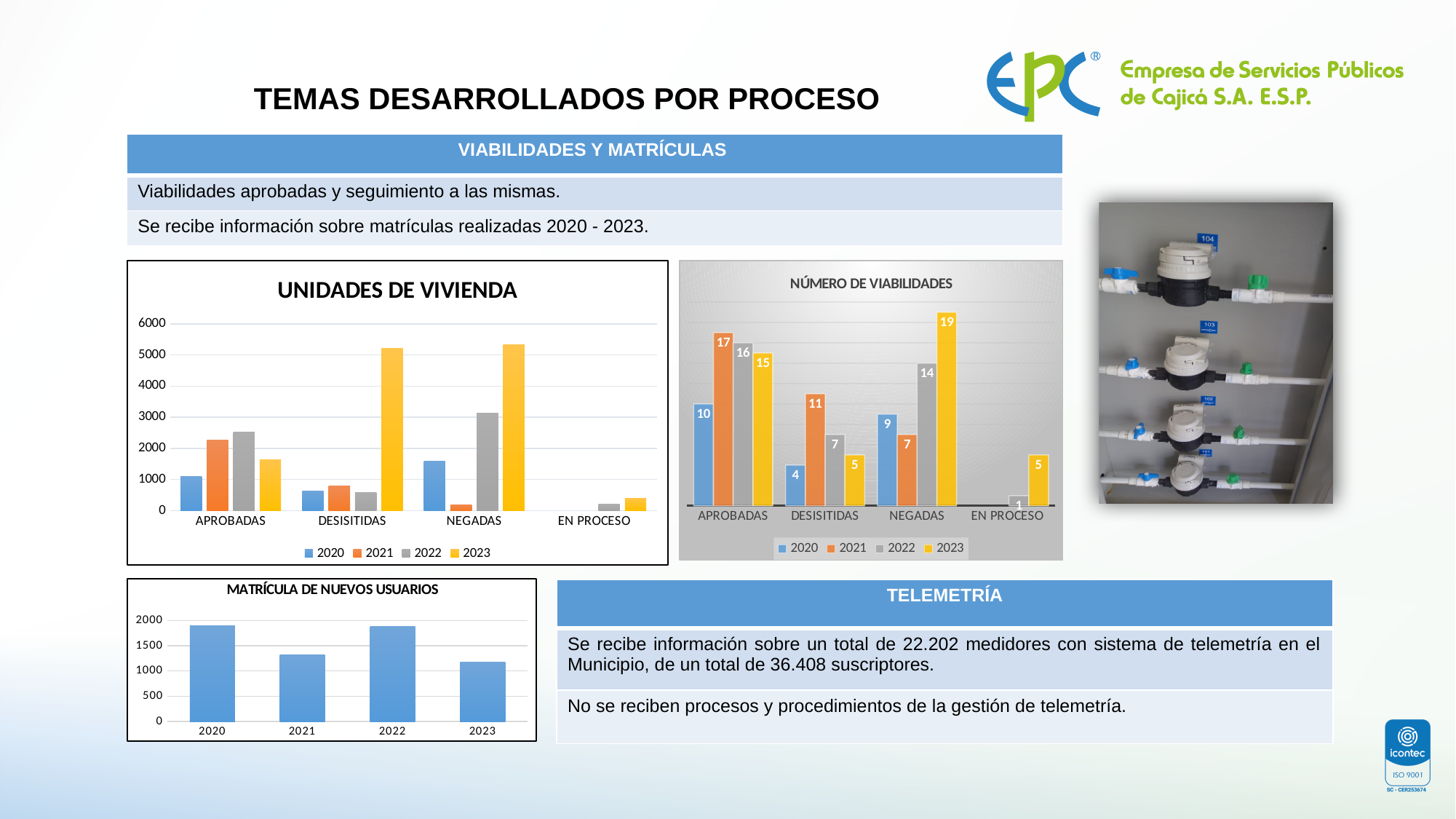
In the NÚMERO DE VIABILIDADES chart, what is the difference between the 2022 and 2021 values in the NEGADAS category? 7 In the NÚMERO DE VIABILIDADES chart, which is larger: the 2020 value for APROBADAS or the 2020 value for NEGADAS? 2020 value for APROBADAS In the NÚMERO DE VIABILIDADES chart, which year has the lowest value in the APROBADAS category? 2020 In the UNIDADES DE VIVIENDA chart, is the value for 2021 in the APROBADAS category greater or less than 2000? greater In the UNIDADES DE VIVIENDA chart, is the value for 2023 in the DESISITIDAS category greater or less than 5000? greater How many series does the legend of the NÚMERO DE VIABILIDADES chart list? 4 In the NÚMERO DE VIABILIDADES chart, what is the value for 2023 in the NEGADAS category? 19 In the NÚMERO DE VIABILIDADES chart, which year has the highest value in the DESISITIDAS category? 2021 In the MATRÍCULA DE NUEVOS USUARIOS chart, is the value for 2023 greater or less than 1500? less How many categories are shown on the x axis of the UNIDADES DE VIVIENDA chart? 4 What kind of chart is MATRÍCULA DE NUEVOS USUARIOS? Bar chart In the NÚMERO DE VIABILIDADES chart, what is the value for 2021 in the APROBADAS category? 17